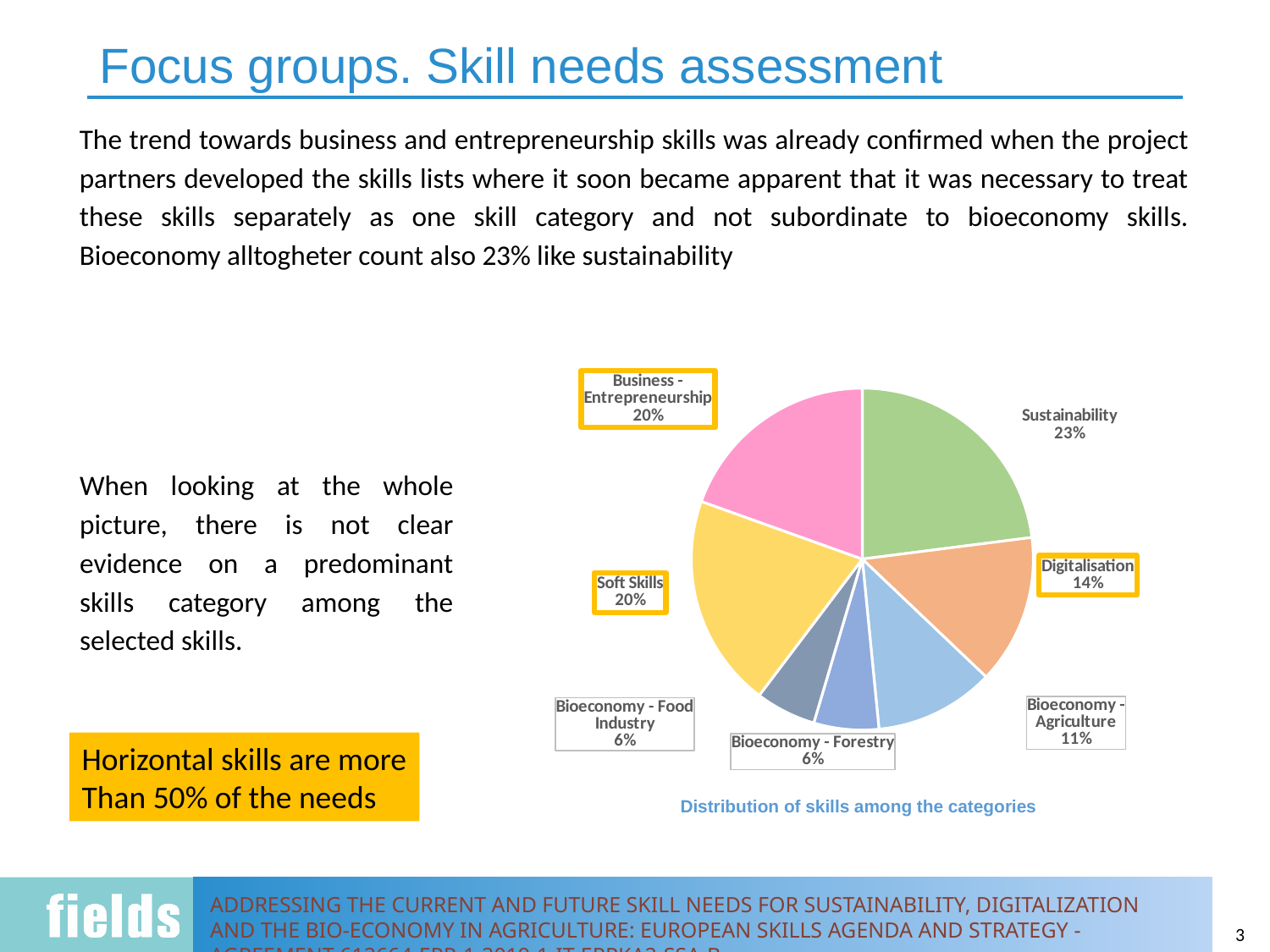
What is the combined share of Bioeconomy - Agriculture, Bioeconomy - Forestry and Bioeconomy - Food Industry? 23% What is the caption printed below the pie chart? Distribution of skills among the categories What is the value shown for Soft Skills? 20% What is the value shown for Digitalisation? 14% Which category has the largest slice of the pie? Sustainability What percentage is shown for Bioeconomy - Agriculture? 11% What kind of chart is shown on the slide? pie chart What share of the pie does Sustainability account for? 23% How many slices does the pie chart have? 7 Which is larger, the share for Digitalisation or the share for Bioeconomy - Agriculture? Digitalisation What percentage is shown for Bioeconomy - Forestry? 6% What is the difference between the Sustainability share and the Digitalisation share? 9%